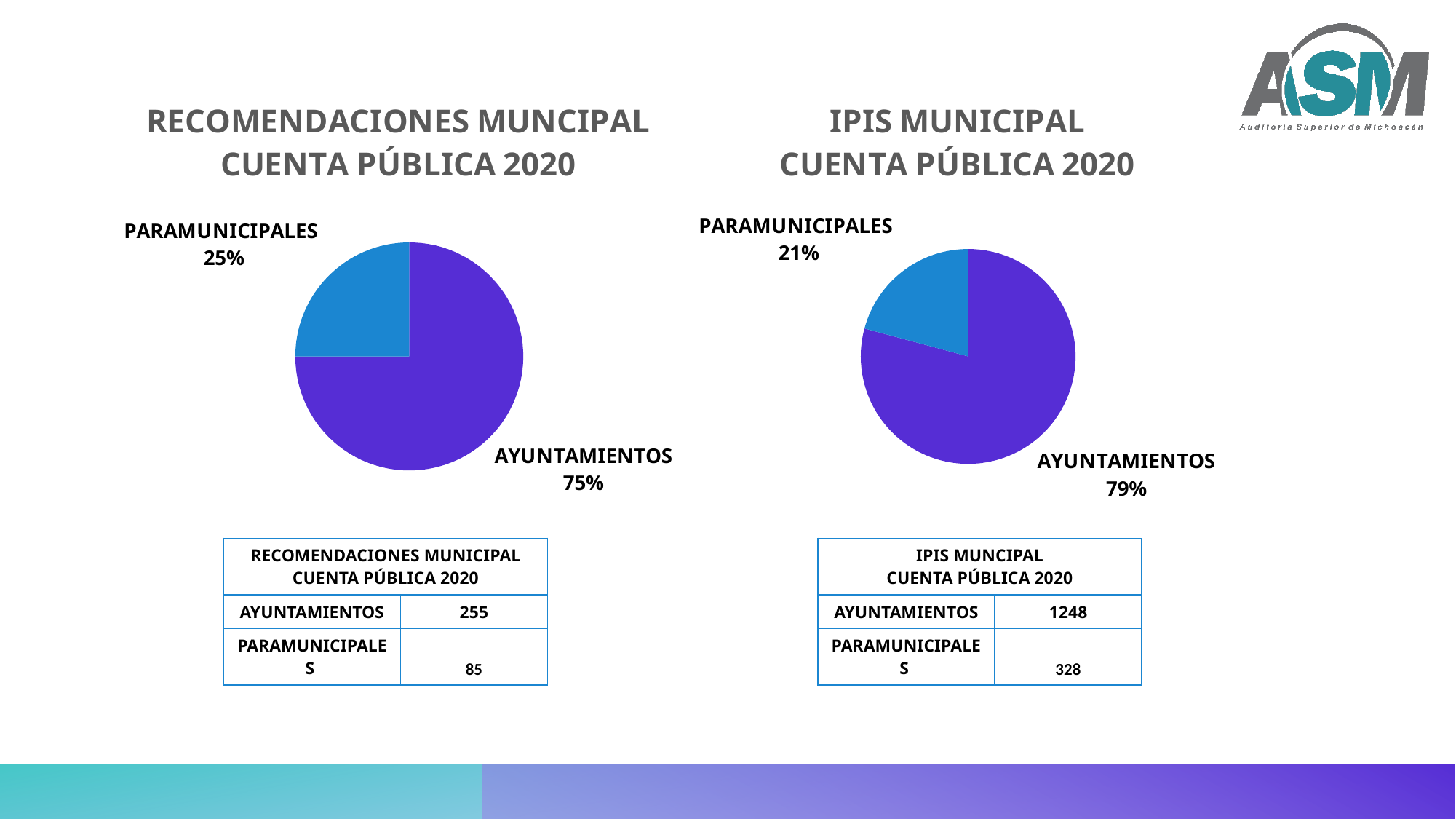
In the 'RECOMENDACIONES MUNCIPAL CUENTA PÚBLICA 2020' pie chart, what share does AYUNTAMIENTOS have? 75% In the 'IPIS MUNICIPAL CUENTA PÚBLICA 2020' chart, what is the difference in percentage points between AYUNTAMIENTOS and PARAMUNICIPALES? 58 percentage points In the 'IPIS MUNICIPAL CUENTA PÚBLICA 2020' pie chart, what share does PARAMUNICIPALES have? 21% In the 'RECOMENDACIONES MUNCIPAL CUENTA PÚBLICA 2020' pie chart, what share does PARAMUNICIPALES have? 25% In the 'RECOMENDACIONES MUNCIPAL CUENTA PÚBLICA 2020' chart, what is the difference in percentage points between AYUNTAMIENTOS and PARAMUNICIPALES? 50 percentage points Which chart shows a larger share for PARAMUNICIPALES, 'RECOMENDACIONES MUNCIPAL CUENTA PÚBLICA 2020' or 'IPIS MUNICIPAL CUENTA PÚBLICA 2020'? RECOMENDACIONES MUNCIPAL CUENTA PÚBLICA 2020 In the 'IPIS MUNICIPAL CUENTA PÚBLICA 2020' chart, which category has the smallest slice? PARAMUNICIPALES What type of chart is used for 'IPIS MUNICIPAL CUENTA PÚBLICA 2020'? Pie chart In the 'RECOMENDACIONES MUNCIPAL CUENTA PÚBLICA 2020' chart, which category has the largest slice? AYUNTAMIENTOS In the 'IPIS MUNICIPAL CUENTA PÚBLICA 2020' chart, what colour is the AYUNTAMIENTOS slice? Purple How many slices does the 'RECOMENDACIONES MUNCIPAL CUENTA PÚBLICA 2020' pie chart have? 2